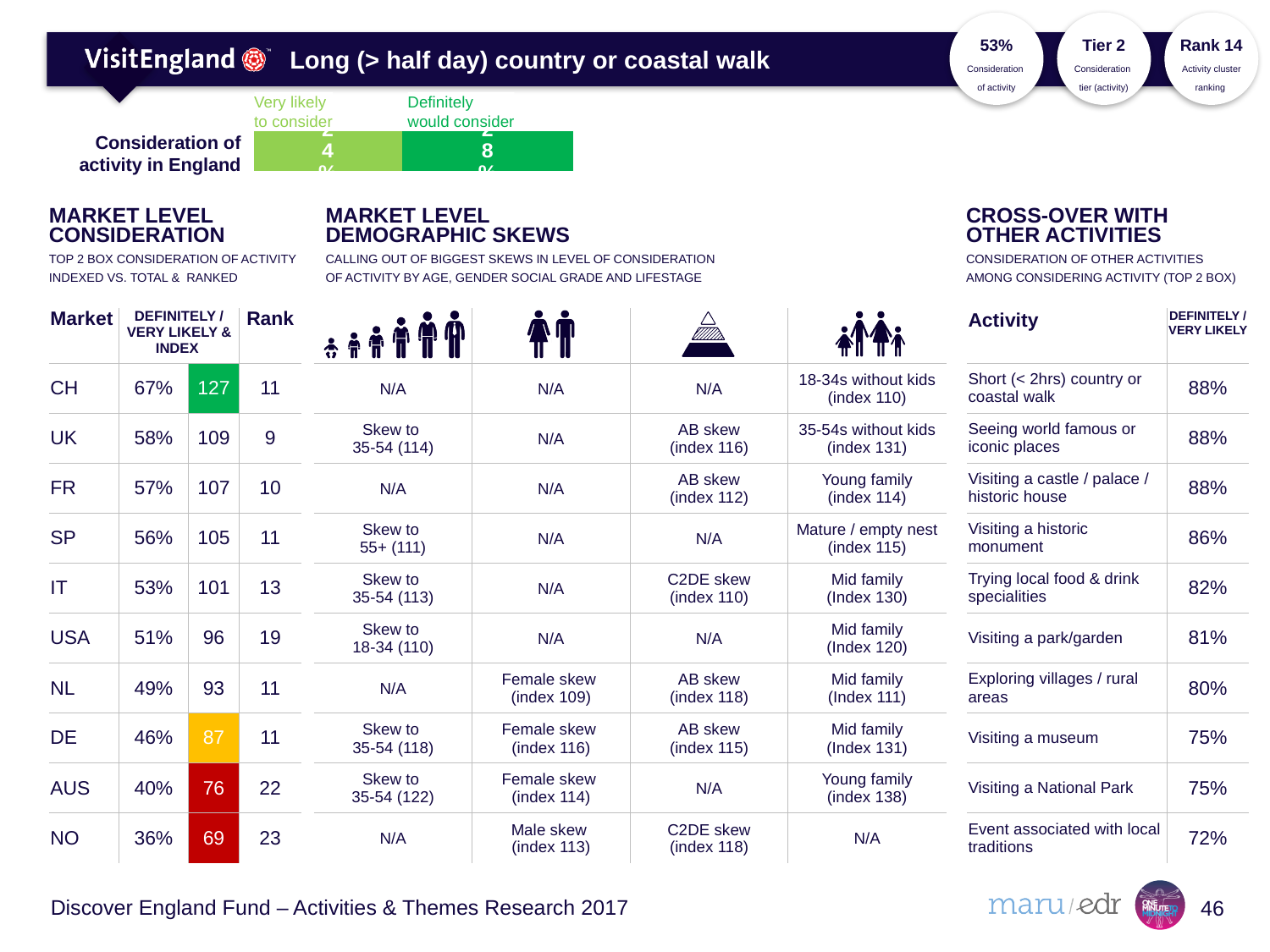
In the 'Consideration of activity in England' chart, which segment is shown in the darker green colour? Definitely would consider In the 'Consideration of activity in England' chart, which segment is the smaller one? Very likely to consider What are the two segment labels shown above the 'Consideration of activity in England' bar chart? Very likely to consider; Definitely would consider How many segments (series) does the 'Consideration of activity in England' bar chart show? 2 In the 'Consideration of activity in England' chart, which segment is larger: 'Very likely to consider' or 'Definitely would consider'? Definitely would consider What kind of chart is the 'Consideration of activity in England' chart? bar chart How many bars does the 'Consideration of activity in England' chart contain? 1